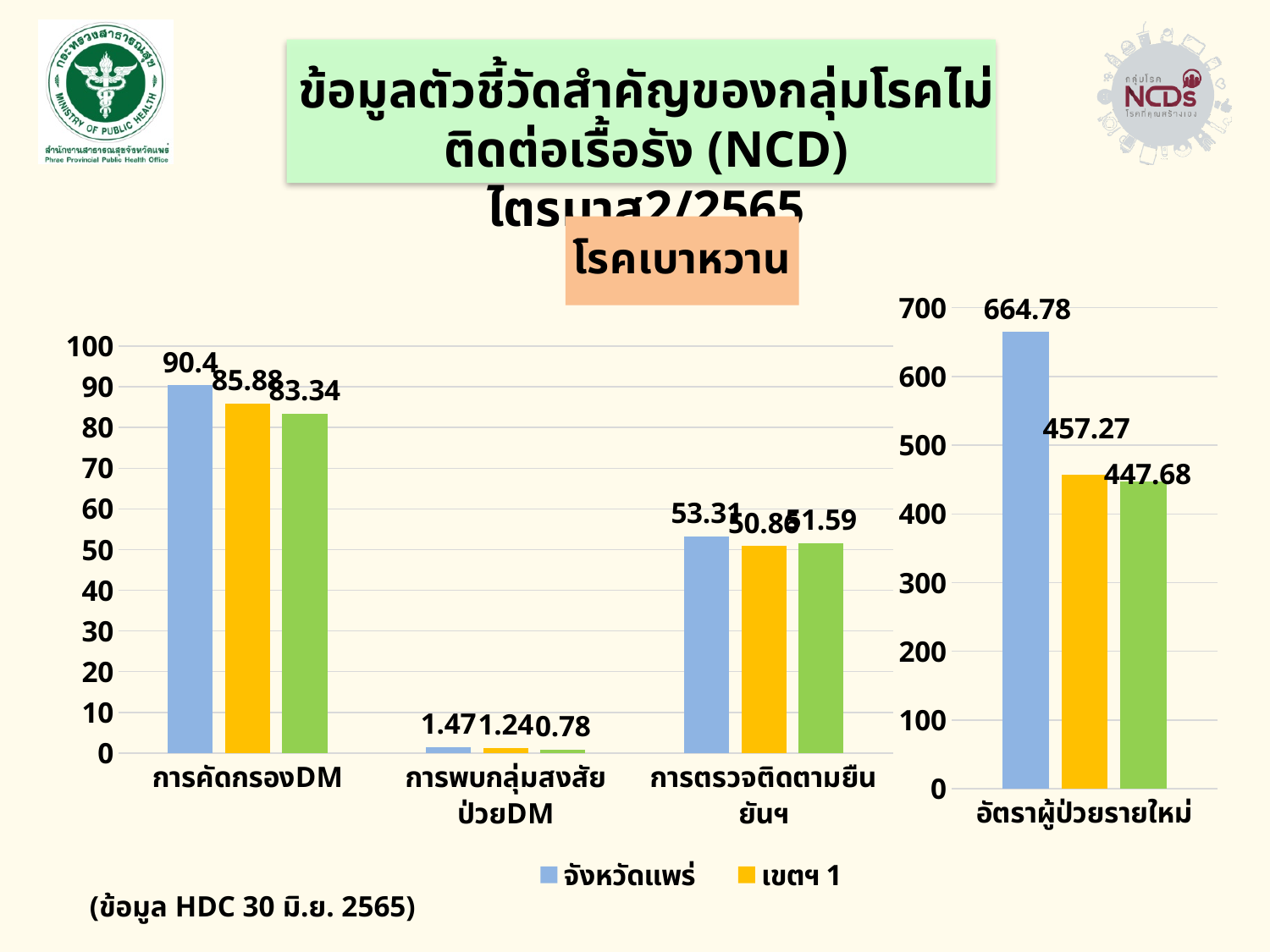
In the left chart, what is the value for จังหวัดแพร่ in the การคัดกรองDM category? 90.4 In the right chart (อัตราผู้ป่วยรายใหม่), what is the difference between the จังหวัดแพร่ value and the เขตฯ 1 value? 207.51 What kind of chart is the left chart? Bar chart In the right chart, is the value for จังหวัดแพร่ greater or less than 600? greater In the right chart (อัตราผู้ป่วยรายใหม่), what is the value for จังหวัดแพร่? 664.78 In the left chart, for การคัดกรองDM, how much higher is the จังหวัดแพร่ value than the เขตฯ 1 value? 4.52 In the left chart, which category has the highest value for จังหวัดแพร่? การคัดกรองDM In the left chart, what is the value for เขตฯ 1 in the การพบกลุ่มสงสัยป่วยDM category? 1.24 In the left chart, for การตรวจติดตามยืนยันฯ, which is larger: จังหวัดแพร่ or เขตฯ 1? จังหวัดแพร่ In the right chart (อัตราผู้ป่วยรายใหม่), what is the value for เขตฯ 1? 457.27 How many categories are shown on the x axis of the left chart? 3 In the left chart, which category has the lowest value for จังหวัดแพร่? การพบกลุ่มสงสัยป่วยDM